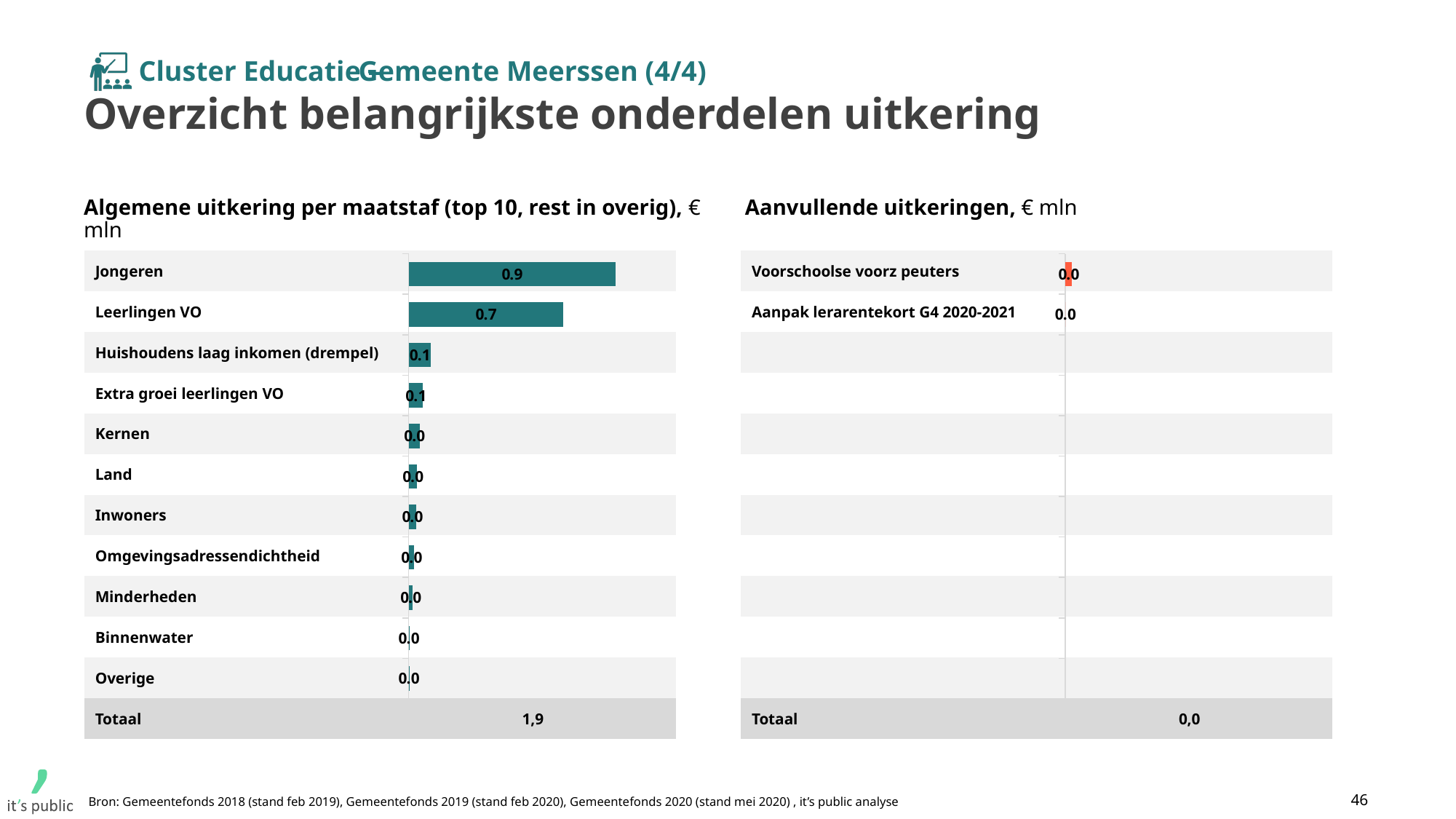
In the chart 'Algemene uitkering per maatstaf', which is larger: the value for Leerlingen VO or the value for Extra groei leerlingen VO? Leerlingen VO In the chart 'Aanvullende uitkeringen', what is the value for Voorschoolse voorz peuters? 0.0 In the chart 'Algemene uitkering per maatstaf', what is the value for Huishoudens laag inkomen (drempel)? 0.1 How many categories are shown in the chart 'Aanvullende uitkeringen' (excluding the Totaal row)? 2 In the chart 'Algemene uitkering per maatstaf', what is the value for Jongeren? 0.9 In the chart 'Algemene uitkering per maatstaf', which category has the highest value? Jongeren What unit is stated in the title of the chart 'Aanvullende uitkeringen'? € mln What kind of chart is 'Algemene uitkering per maatstaf'? Bar chart In the chart 'Algemene uitkering per maatstaf', what is the difference between the values for Jongeren and Leerlingen VO? 0.2 In the chart 'Algemene uitkering per maatstaf', what is the value for Leerlingen VO? 0.7 How many categories are shown in the chart 'Algemene uitkering per maatstaf' (excluding the Totaal row)? 11 What is the Totaal shown for the chart 'Algemene uitkering per maatstaf'? 1,9